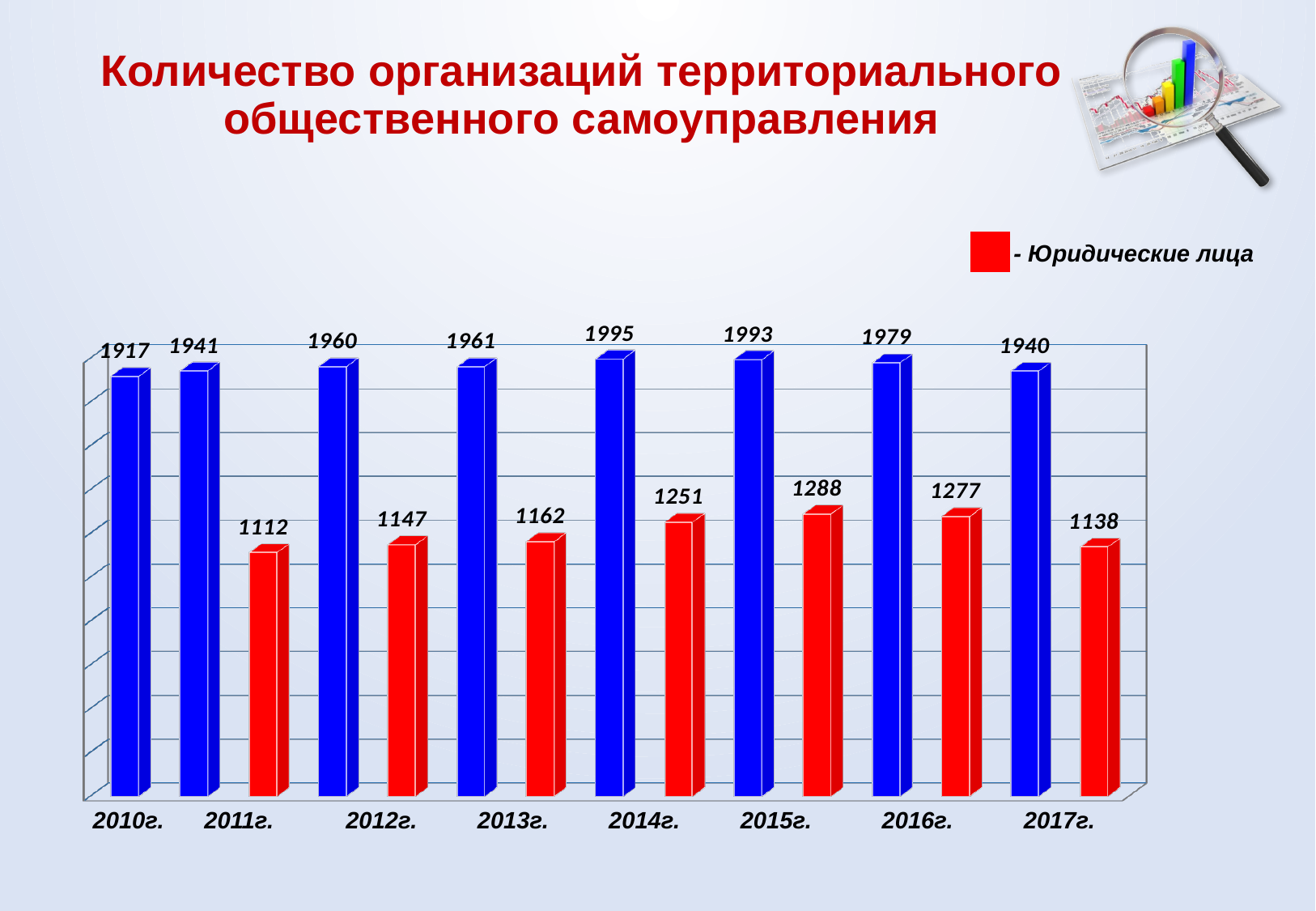
In which year is the red bar (Юридические лица) the lowest? 2011г. Do the red bars rise or fall from 2011г. to 2015г.? rise How many red bars (Юридические лица) are plotted on the chart? 7 What is the value of the red bar (Юридические лица) for 2015г.? 1288 In which year is the blue bar the lowest? 2010г. What is the value of the blue bar for 2014г.? 1995 Which is larger: the red bar for 2016г. or the red bar for 2014г.? 2016г. What is the value of the blue bar for 2010г.? 1917 How many years are shown on the x axis? 8 What is the difference between the blue bar and the red bar for 2017г.? 802 In which year is the blue bar the highest? 2014г. By how much does the blue bar for 2013г. exceed the blue bar for 2010г.? 44